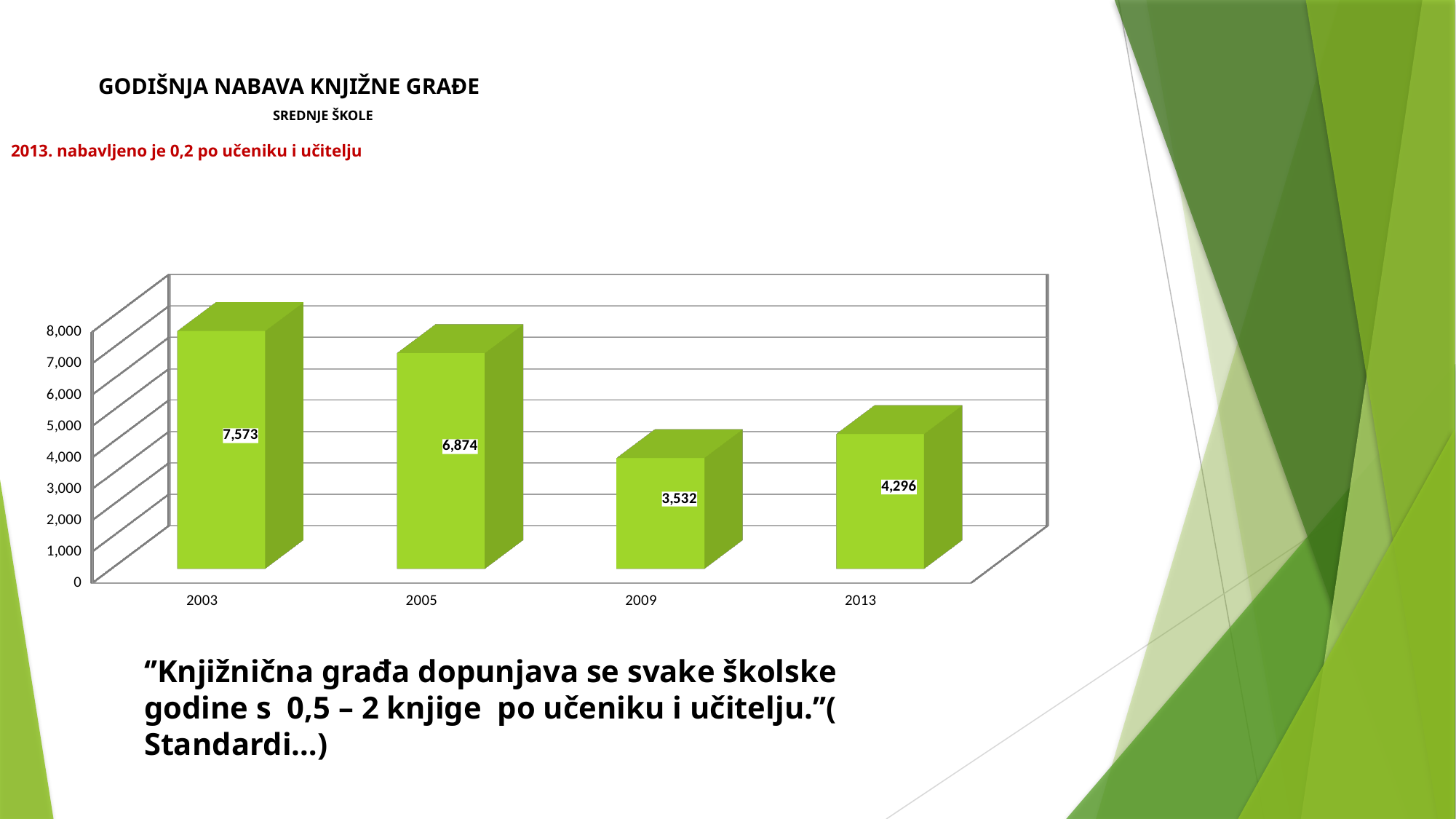
What is the value for 2009? 3,532 What is the difference between the values for 2013 and 2009? 764 Do the values rise or fall from 2003 to 2009? fall What is the difference between the values for 2003 and 2005? 699 What is the value for 2003? 7,573 How many years are shown on the x axis? 4 Which is larger, the value for 2005 or the value for 2013? 2005 Which year has the lowest value? 2009 What kind of chart is shown on the slide? bar chart Which year has the highest value? 2003 What is the value for 2013? 4,296 What is the title of the chart? GODIŠNJA NABAVA KNJIŽNE GRAĐE